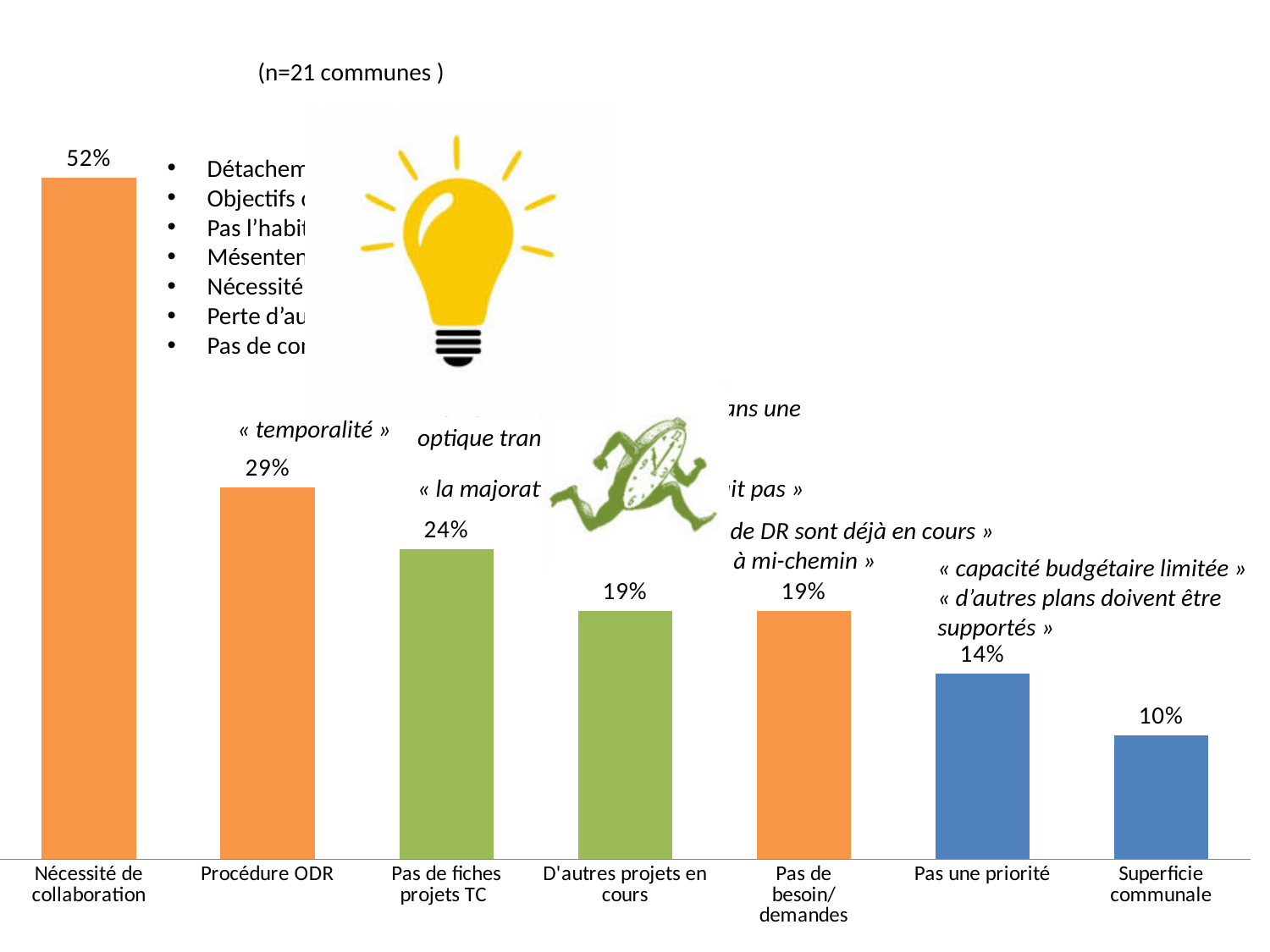
Do the values rise or fall from left to right along the x axis? Fall How many categories are shown in the bar chart? 7 What is the difference between the values for Nécessité de collaboration and Procédure ODR? 23% What is the difference between the values for Pas une priorité and Superficie communale? 4% What is the value for Pas de fiches projets TC? 24% What kind of chart is shown on the slide? Bar chart What is the value for Superficie communale? 10% What is the value for Nécessité de collaboration? 52% Which category has the lowest value? Superficie communale Which is larger, the value for Pas de fiches projets TC or the value for Pas une priorité? Pas de fiches projets TC Which category has the highest value? Nécessité de collaboration What is the value for Procédure ODR? 29%